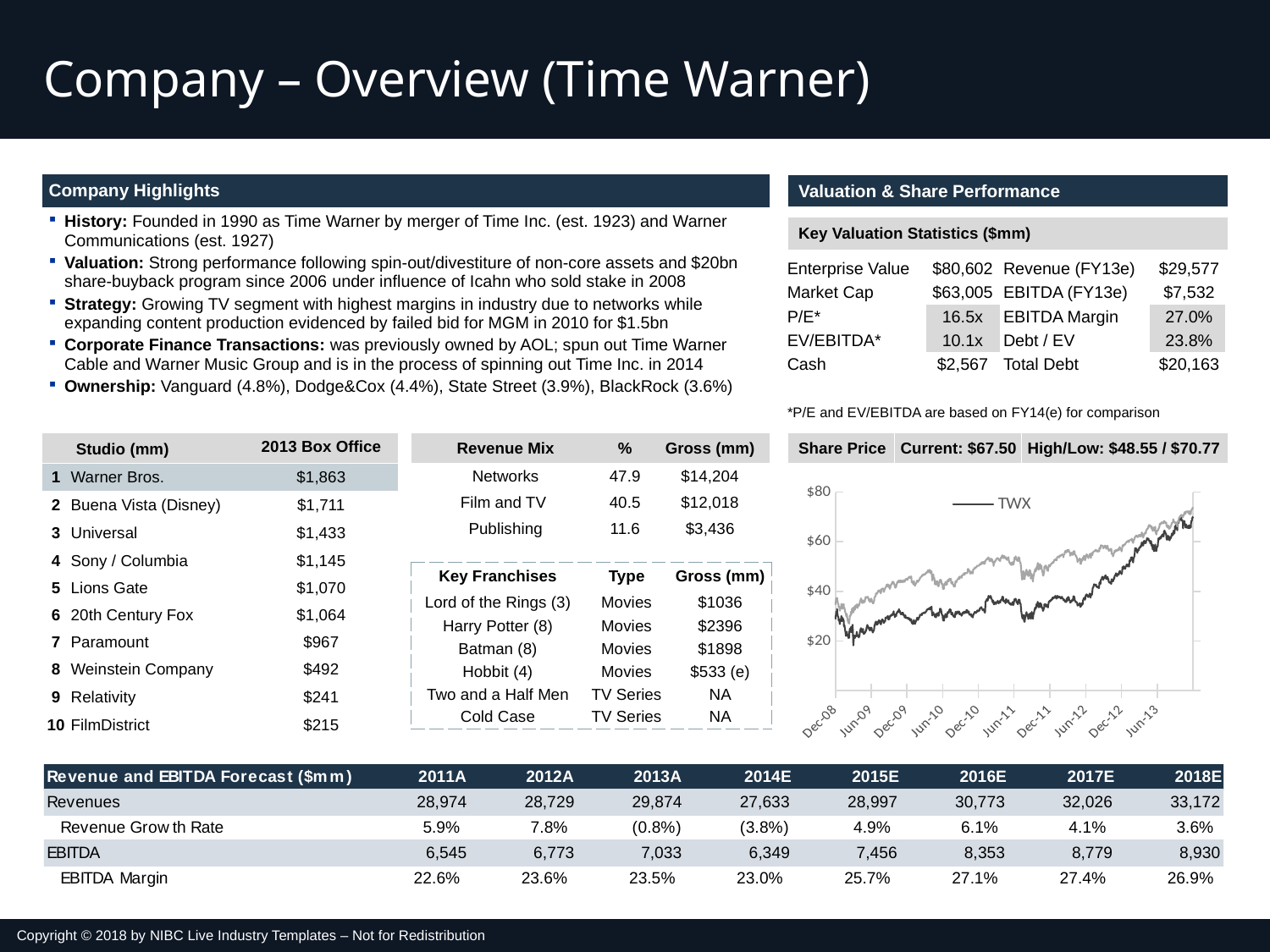
What is the name of the series shown in the legend of the Share Price chart? TWX Does the TWX share price generally rise or fall from Dec-08 to Jun-13 in the Share Price chart? rise What is the first date label on the x axis of the Share Price chart? Dec-08 In the Share Price chart, is the TWX value at Dec-10 greater or less than $60? less How many date labels are shown on the x axis of the Share Price chart? 10 In the Share Price chart, is the TWX value at Dec-08 greater or less than $40? less What is the highest tick value shown on the y axis of the Share Price chart? $80 What kind of chart is the Share Price chart? line chart How many series does the legend of the Share Price chart list? 1